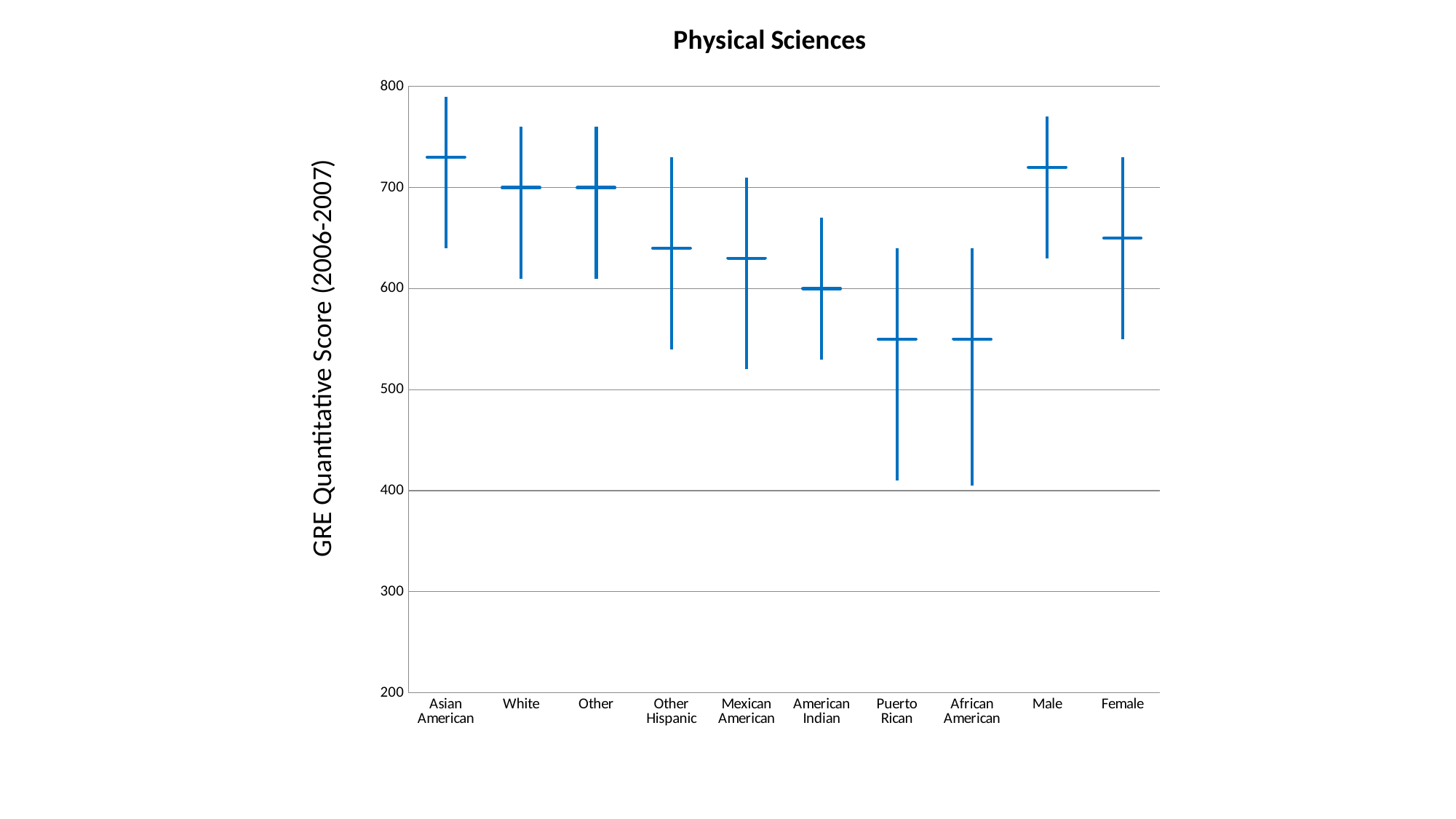
Which is larger, the value for White or the value for African American? White Is the value for Female greater or less than 700? less Is the value for Puerto Rican greater or less than 600? less Is the value for Male greater or less than 700? greater What is the value for White? 700 How many categories are shown on the x axis? 10 What is the value for Other? 700 Which is larger, the value for Male or the value for Female? Male What is the difference between the values for White and American Indian? 100 What is the value for American Indian? 600 What is the label of the vertical axis? GRE Quantitative Score (2006-2007)